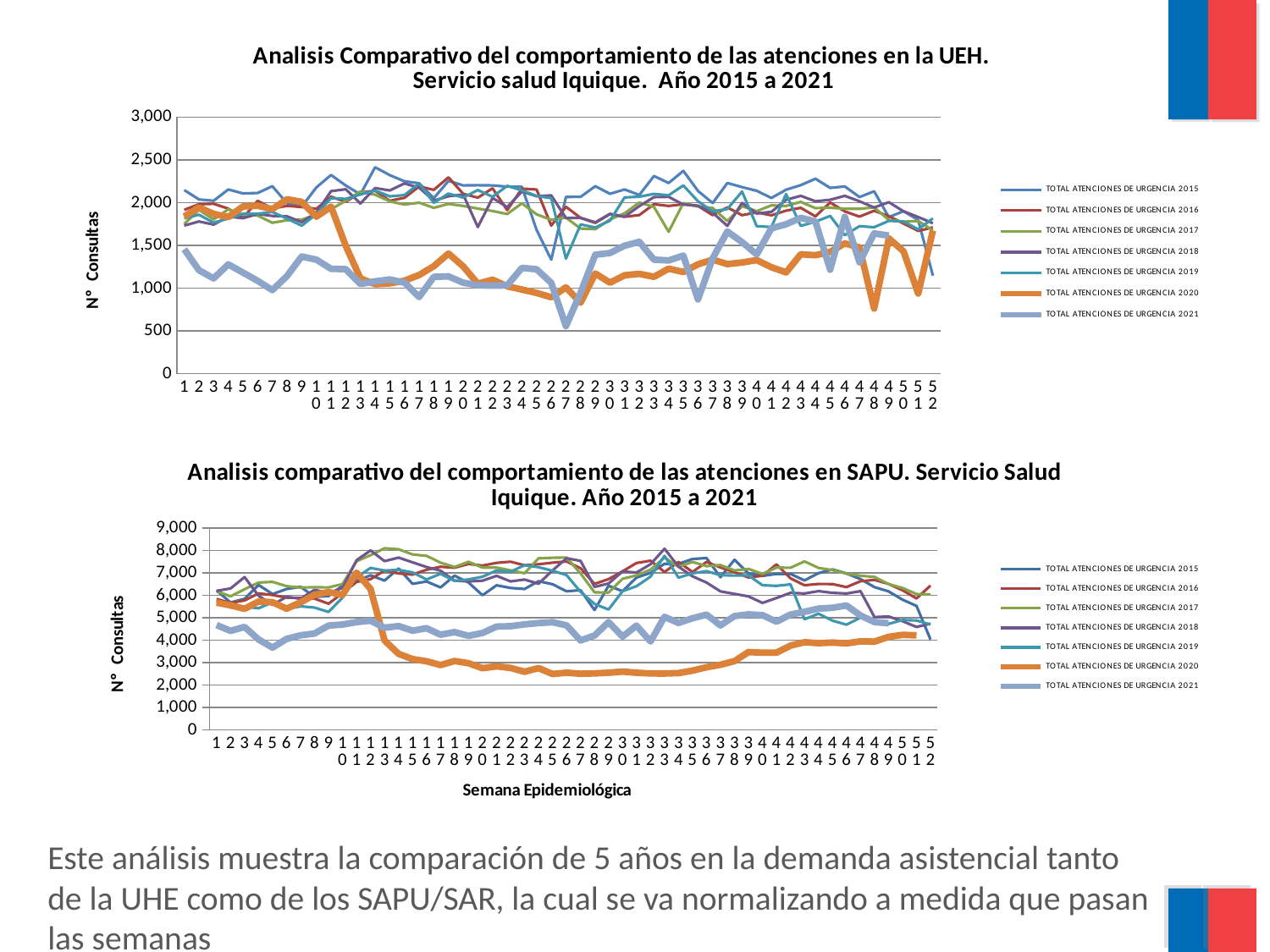
In the top (UEH) chart, is the value for TOTAL ATENCIONES DE URGENCIA 2020 at week 1 greater or less than 1,500? greater In the top (UEH) chart, is the value for TOTAL ATENCIONES DE URGENCIA 2021 at week 27 greater or less than 1,000? less What is the y-axis title of the top (UEH) chart? N° Consultas How many series does the legend of the top (UEH) chart list? 7 In the bottom (SAPU) chart, is the value for TOTAL ATENCIONES DE URGENCIA 2020 at week 30 greater or less than 3,000? less What is the x-axis title of the bottom (SAPU) chart? Semana Epidemiológica How many epidemiological weeks are plotted along the x axis of the bottom (SAPU) chart? 52 What type of chart is the bottom chart about atenciones en SAPU? Line chart How many series does the legend of the bottom (SAPU) chart list? 7 What type of chart is the top chart titled 'Analisis Comparativo del comportamiento de las atenciones en la UEH'? Line chart In the bottom (SAPU) chart, which series has the lowest value at week 30? TOTAL ATENCIONES DE URGENCIA 2020